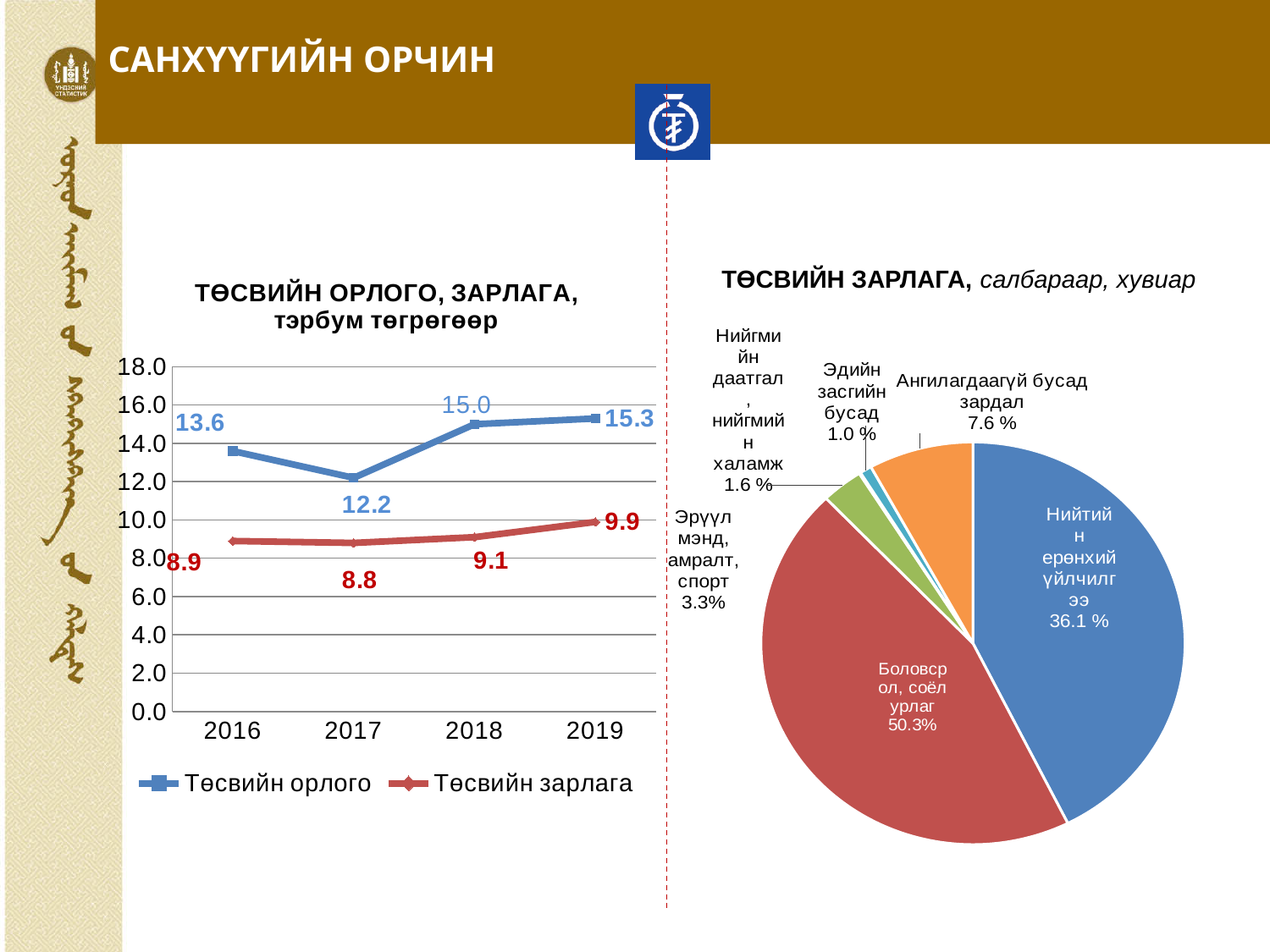
In the line chart 'ТӨСВИЙН ОРЛОГО, ЗАРЛАГА, тэрбум төгрөгөөр', what is the value of Төсвийн орлого in 2017? 12.2 In the pie chart 'ТӨСВИЙН ЗАРЛАГА, салбараар, хувиар', which is larger: Ангилагдаагүй бусад зардал or Эрүүл мэнд, амралт, спорт? Ангилагдаагүй бусад зардал In the line chart 'ТӨСВИЙН ОРЛОГО, ЗАРЛАГА, тэрбум төгрөгөөр', what is the value of Төсвийн зарлага in 2019? 9.9 In the line chart 'ТӨСВИЙН ОРЛОГО, ЗАРЛАГА, тэрбум төгрөгөөр', in which year is Төсвийн орлого highest? 2019 In the line chart 'ТӨСВИЙН ОРЛОГО, ЗАРЛАГА, тэрбум төгрөгөөр', in which year is Төсвийн зарлага lowest? 2017 In the line chart 'ТӨСВИЙН ОРЛОГО, ЗАРЛАГА, тэрбум төгрөгөөр', what is the difference between Төсвийн орлого and Төсвийн зарлага in 2018? 5.9 In the pie chart 'ТӨСВИЙН ЗАРЛАГА, салбараар, хувиар', how many slices are there? 6 In the pie chart 'ТӨСВИЙН ЗАРЛАГА, салбараар, хувиар', what share does Боловсрол, соёл урлаг have? 50.3% What kind of chart is the left chart 'ТӨСВИЙН ОРЛОГО, ЗАРЛАГА, тэрбум төгрөгөөр'? line chart In the pie chart 'ТӨСВИЙН ЗАРЛАГА, салбараар, хувиар', which slice is the smallest? Эдийн засгийн бусад In the line chart 'ТӨСВИЙН ОРЛОГО, ЗАРЛАГА, тэрбум төгрөгөөр', how many series does the legend list? 2 In the line chart 'ТӨСВИЙН ОРЛОГО, ЗАРЛАГА, тэрбум төгрөгөөр', how many years are shown on the x axis? 4